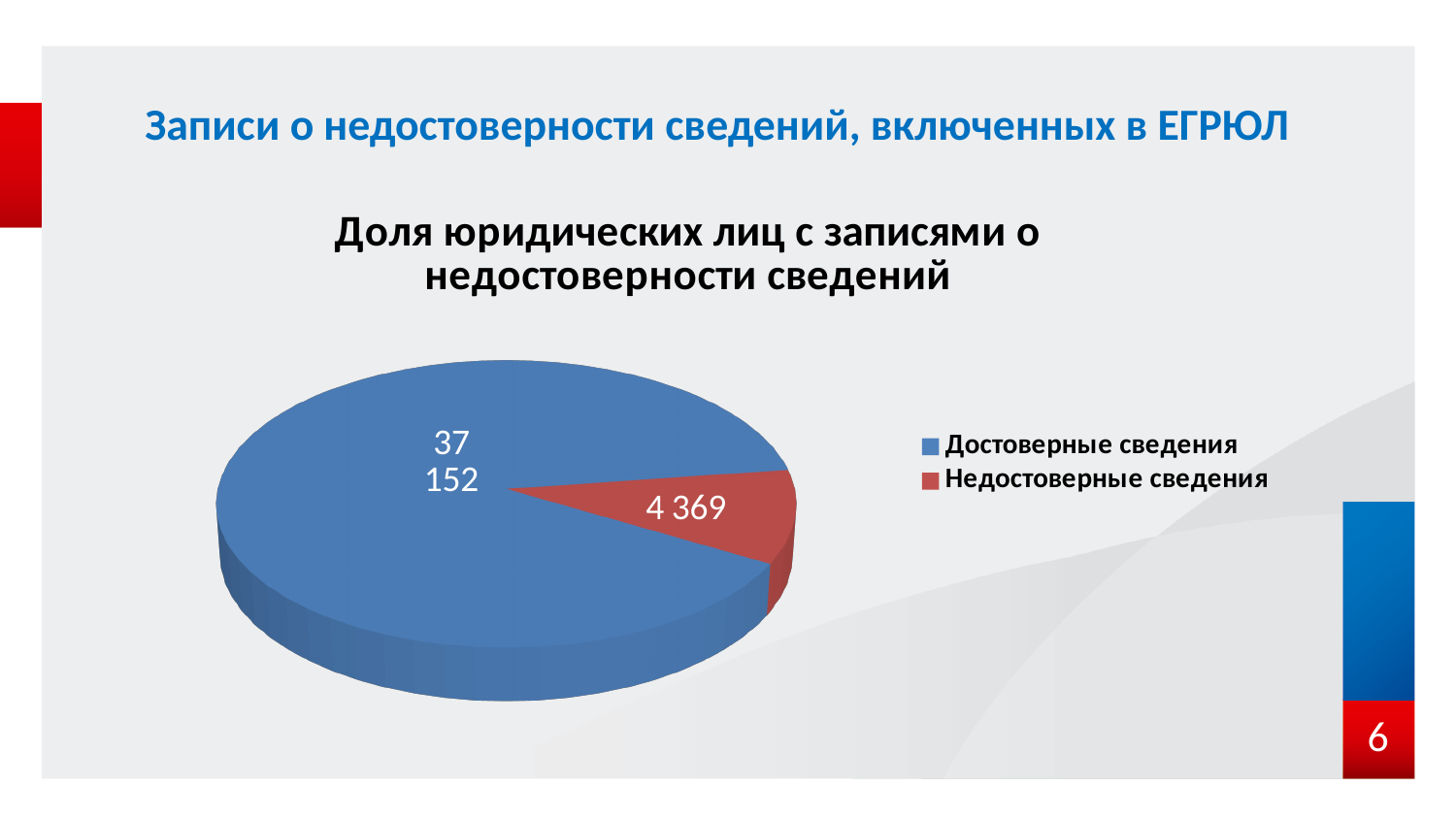
How many entries does the legend list? 2 Which is larger: the value for "Достоверные сведения" or for "Недостоверные сведения"? Достоверные сведения What is the value for "Достоверные сведения" in the pie chart? 37 152 What type of chart is shown on the slide? Pie chart How many slices does the pie chart have? 2 What is the title of the pie chart? Доля юридических лиц с записями о недостоверности сведений Which category has the smallest slice in the pie chart? Недостоверные сведения Which category has the largest slice in the pie chart? Достоверные сведения What is the total of the two values shown in the pie chart? 41 521 What is the difference between the values for "Достоверные сведения" and "Недостоверные сведения"? 32 783 What is the value for "Недостоверные сведения" in the pie chart? 4 369 What colour is the slice for "Недостоверные сведения"? Red